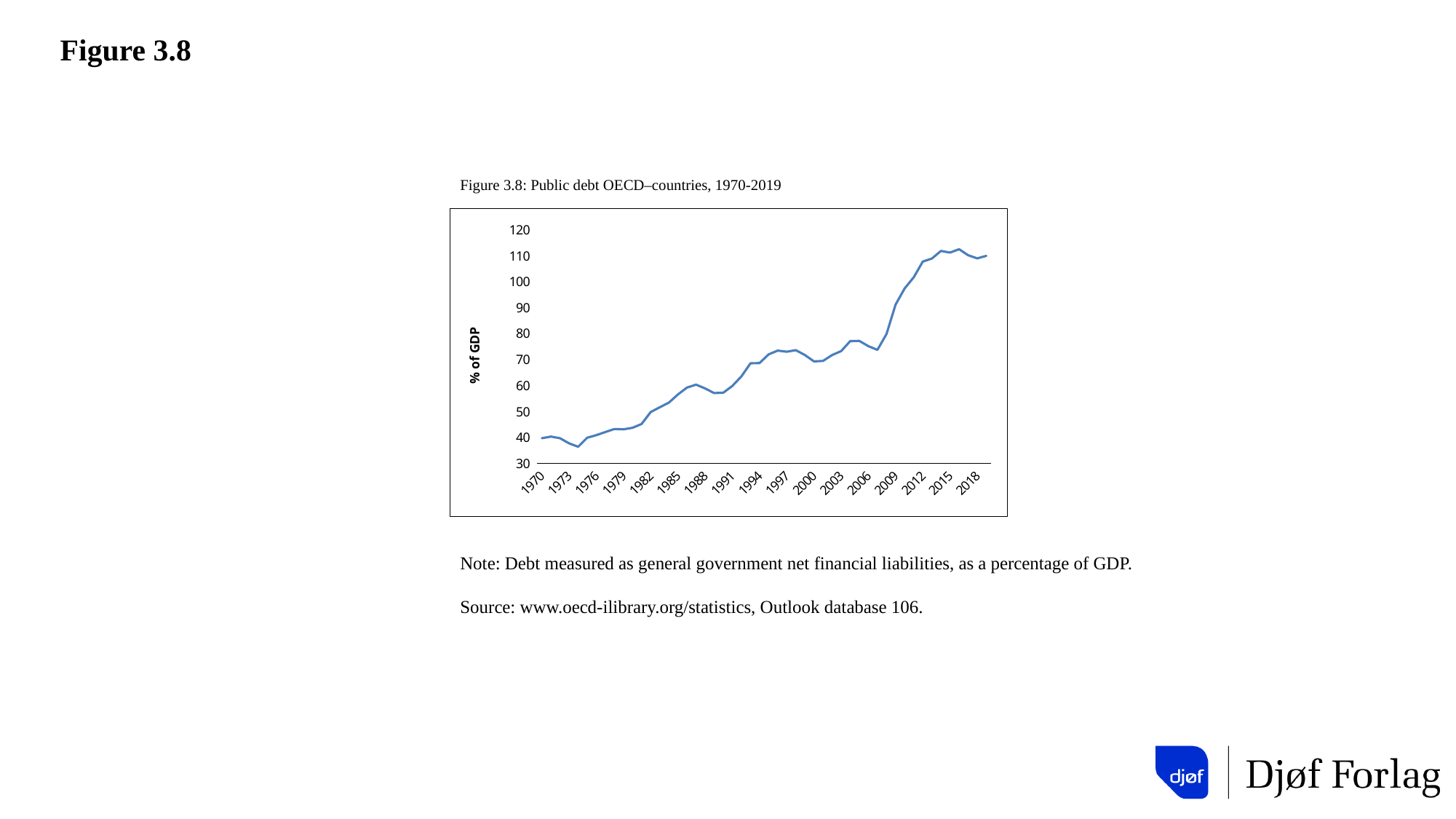
What is the title of the chart? Figure 3.8: Public debt OECD–countries, 1970-2019 What is the label on the vertical axis of the chart? % of GDP Is the value for 2009 greater or less than 80? greater Overall, does public debt as a % of GDP rise or fall from 1970 to 2019? Rise Is the value for 2012 greater or less than 100? greater What kind of chart is shown in Figure 3.8? Line chart Is the value for 1985 greater or less than 50? greater Which year has a higher public debt as a % of GDP, 1970 or 2012? 2012